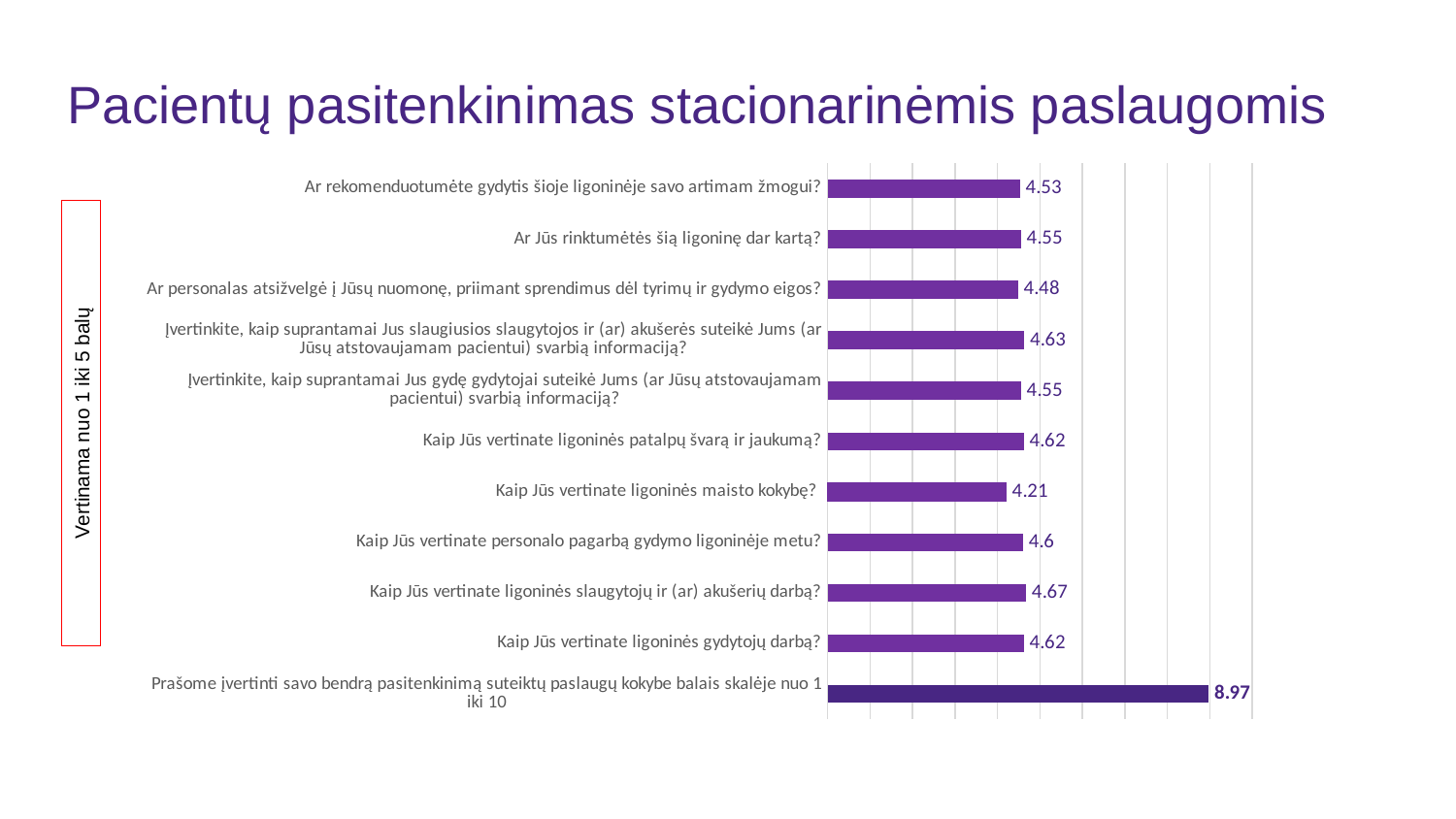
What value is shown for "Kaip Jūs vertinate ligoninės maisto kokybę?"? 4.21 How many categories (questions) are plotted in the chart? 11 What type of chart is shown on the slide? Bar chart What does the vertical text label to the left of the chart say? Vertinama nuo 1 iki 5 balų Which category has the highest value in the chart? Prašome įvertinti savo bendrą pasitenkinimą suteiktų paslaugų kokybe balais skalėje nuo 1 iki 10 What is the title of the slide containing the chart? Pacientų pasitenkinimas stacionarinėmis paslaugomis What value is shown for "Kaip Jūs vertinate ligoninės slaugytojų ir (ar) akušerių darbą?"? 4.67 What value is shown for "Ar personalas atsižvelgė į Jūsų nuomonę, priimant sprendimus dėl tyrimų ir gydymo eigos?"? 4.48 Which is larger: the value for "Ar Jūs rinktumėtės šią ligoninę dar kartą?" or the value for "Kaip Jūs vertinate ligoninės patalpų švarą ir jaukumą?"? Kaip Jūs vertinate ligoninės patalpų švarą ir jaukumą? What is the difference between the value for "Kaip Jūs vertinate ligoninės slaugytojų ir (ar) akušerių darbą?" and the value for "Kaip Jūs vertinate ligoninės maisto kokybę?"? 0.46 Which category has the lowest value in the chart? Kaip Jūs vertinate ligoninės maisto kokybę? What value is shown for the overall satisfaction question rated on a scale from 1 to 10 ("Prašome įvertinti savo bendrą pasitenkinimą...")? 8.97